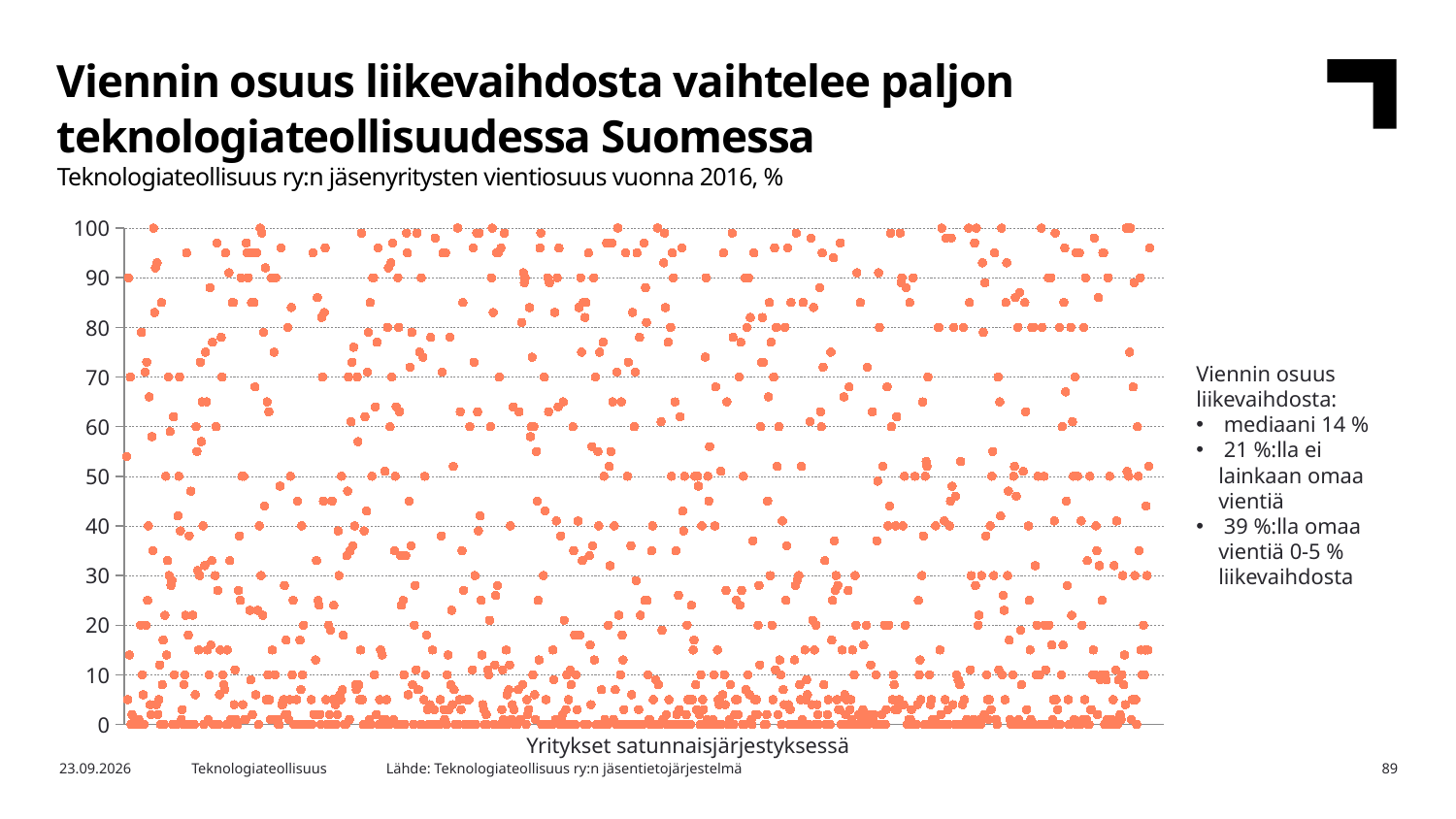
What is the label of the x axis of the chart? Yritykset satunnaisjärjestyksessä What is the subtitle describing the chart's data? Teknologiateollisuus ry:n jäsenyritysten vientiosuus vuonna 2016, % What is the lowest export share value shown for companies in the chart? 0 What kind of chart is shown on the slide? scatter chart What is the highest export share value reached by any company in the chart? 100